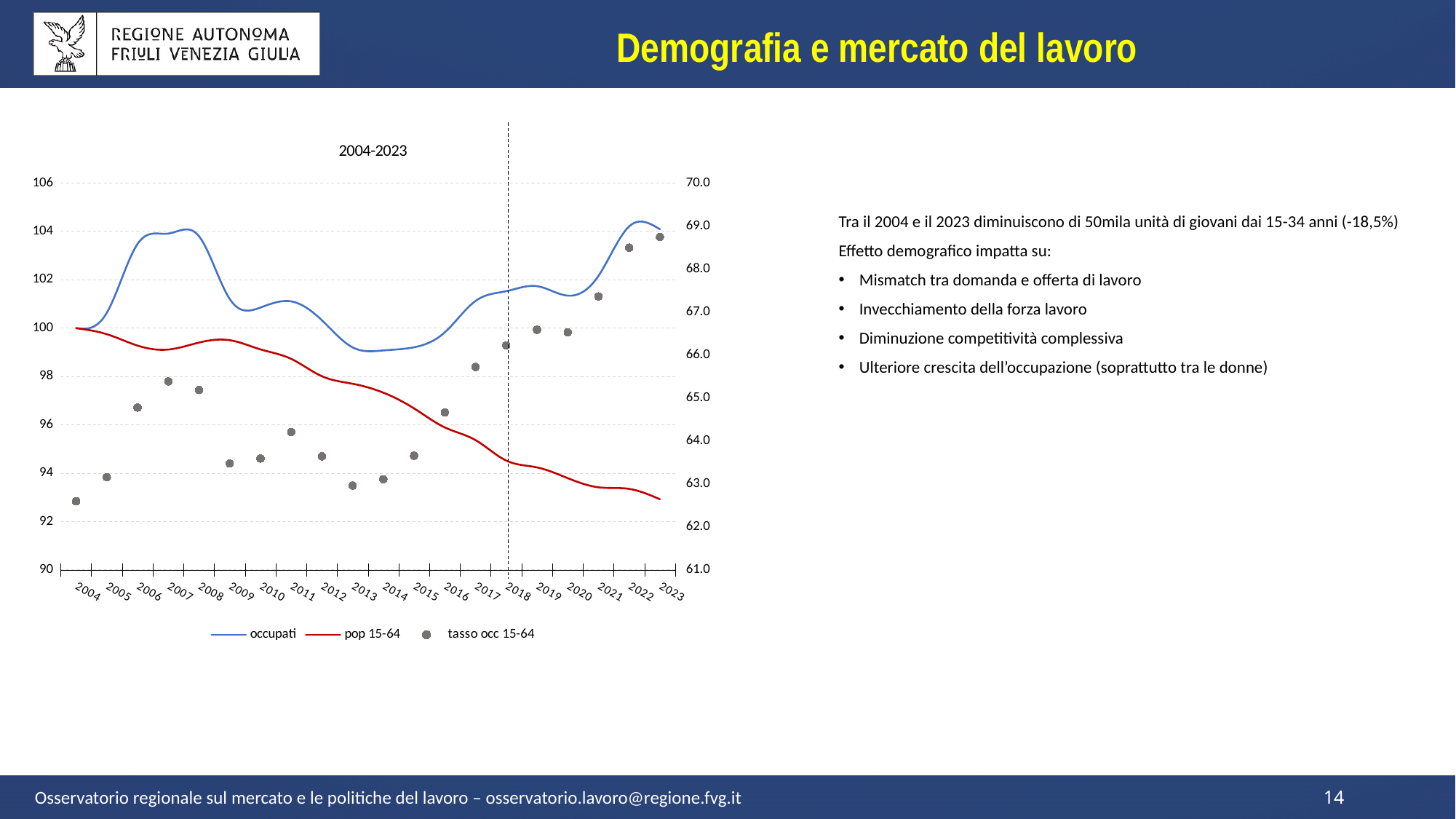
How many series does the chart legend list? 3 What is the title of the chart? 2004-2023 In which year does the occupati series reach its highest value? 2022 What kind of chart is shown on the slide? line chart In which year is the pop 15-64 series at its lowest? 2023 Is the value of pop 15-64 in 2023 greater or less than 94? less Which series is drawn in red in the chart? pop 15-64 Is the value of tasso occ 15-64 in 2023 greater or less than 68.0? greater Does the pop 15-64 series rise or fall from 2004 to 2023? fall What is the value of occupati in 2004? 100 How many years are plotted along the x axis of the chart? 20 In which year is tasso occ 15-64 at its lowest? 2004